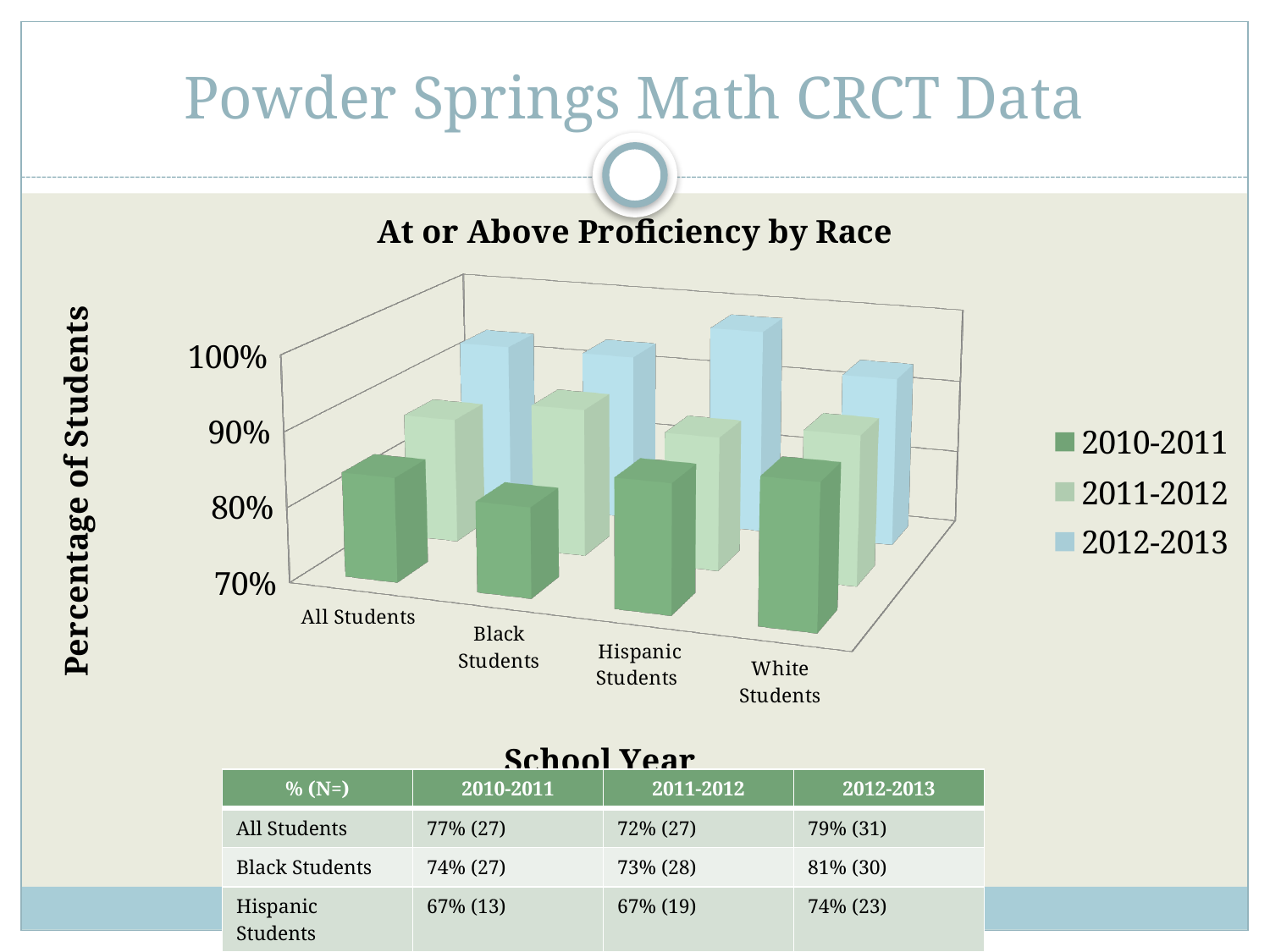
Did the percentage for Hispanic Students rise or fall from 2011-2012 to 2012-2013? rise How many student groups are shown along the x axis of the chart? 4 How many series does the chart legend list? 3 What is the label on the vertical axis of the chart? Percentage of Students What type of chart is shown on the slide? bar chart What is the title of the chart? At or Above Proficiency by Race